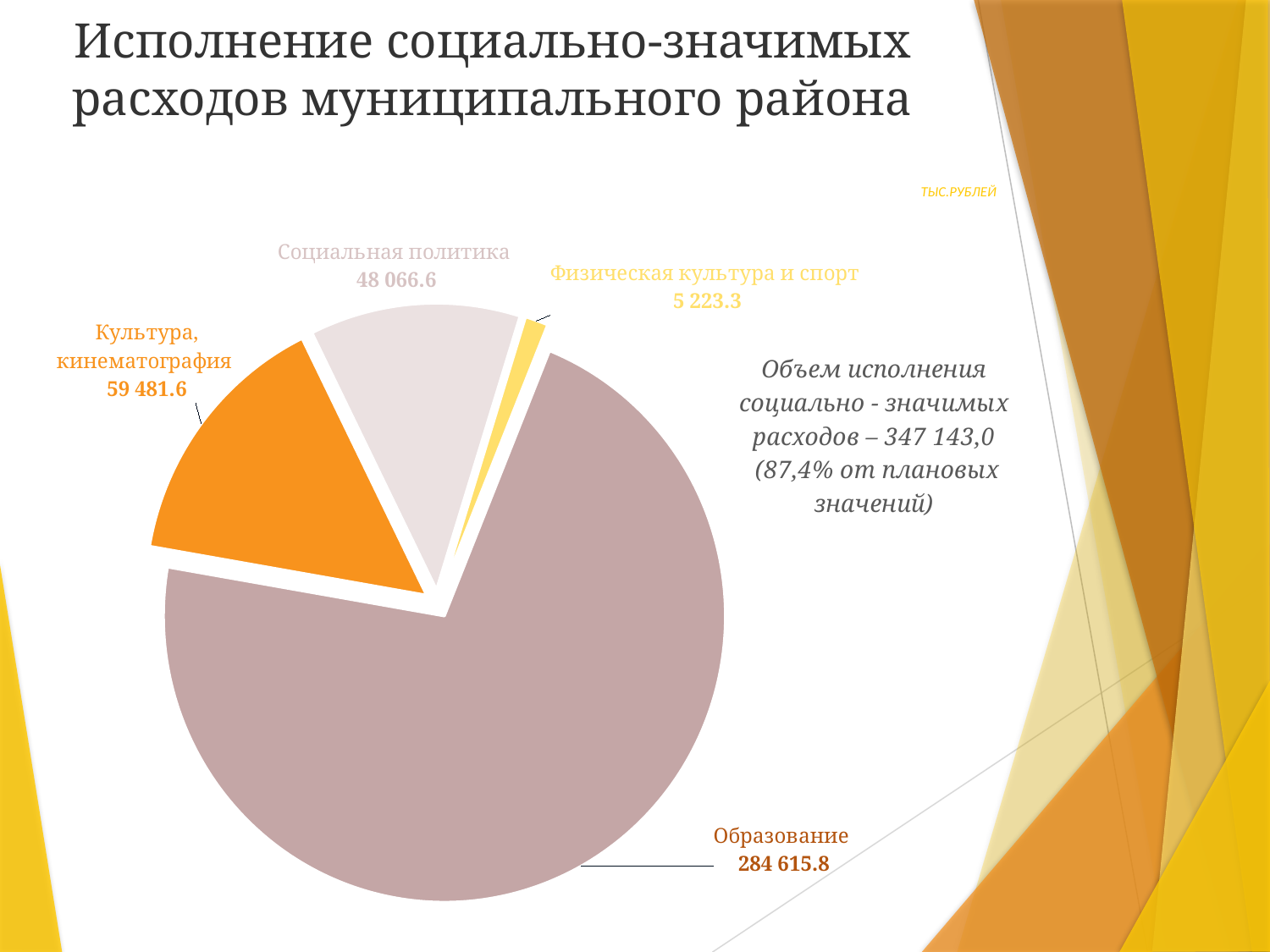
How many slices does the pie chart have? 4 What is the value for Образование? 284 615.8 What is the difference between the values for Образование and Культура, кинематография? 225 134.2 Which is larger: Культура, кинематография or Социальная политика? Культура, кинематография What kind of chart is shown on the slide? pie chart What is the value for Физическая культура и спорт? 5 223.3 What is the value for Культура, кинематография? 59 481.6 Which category has the largest slice of the pie? Образование Which category has the smallest slice of the pie? Физическая культура и спорт What is the difference between the values for Культура, кинематография and Социальная политика? 11 415.0 In what units are the values on the chart given, according to the label on the slide? тыс.рублей What is the value for Социальная политика? 48 066.6